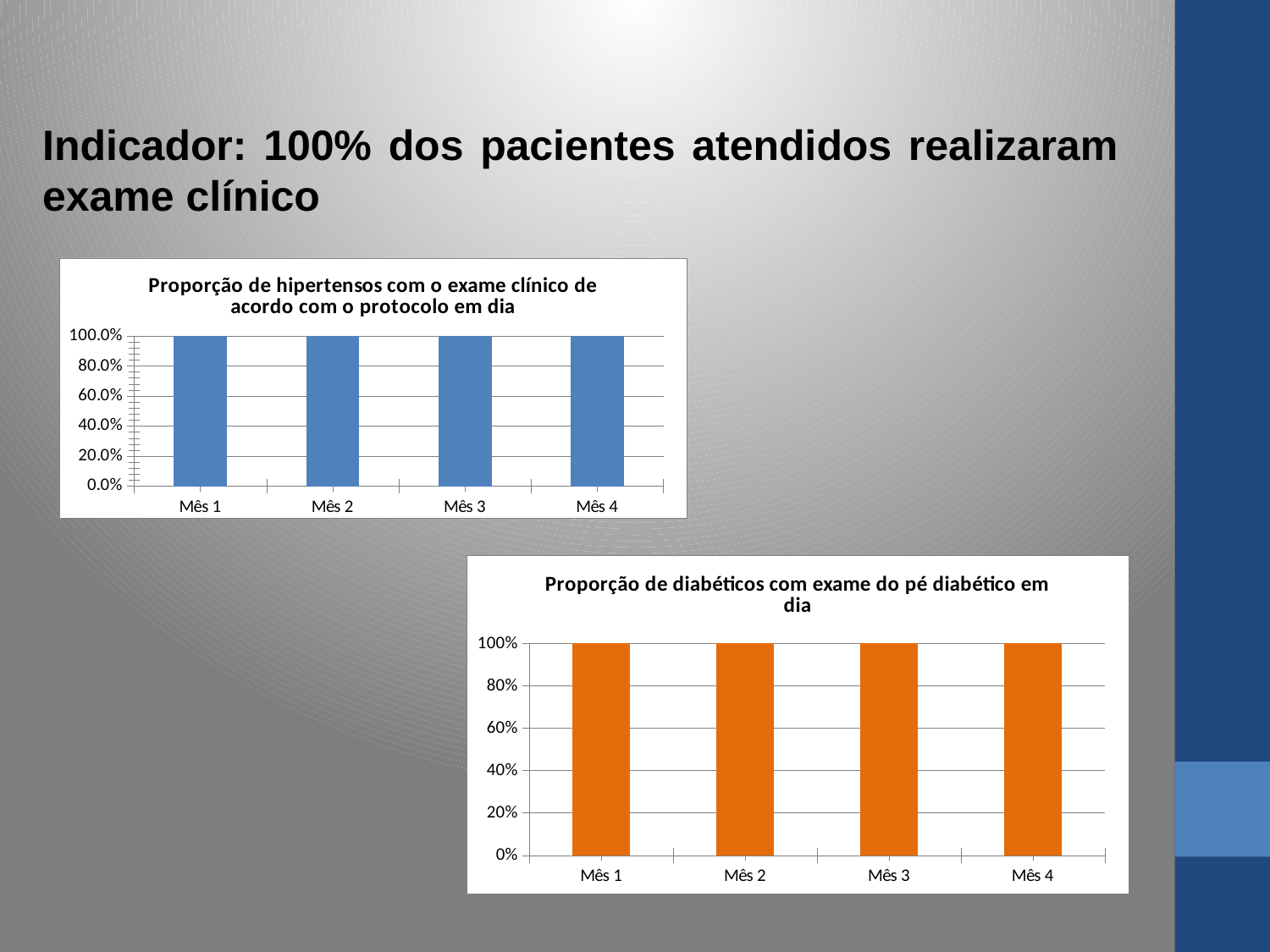
What colour are the bars in the chart titled 'Proporção de diabéticos com exame do pé diabético em dia'? Orange What kind of chart is the bottom-right chart on the slide? Bar chart What is the title of the top-left chart on the slide? Proporção de hipertensos com o exame clínico de acordo com o protocolo em dia In the chart titled 'Proporção de diabéticos com exame do pé diabético em dia', is the value for Mês 2 greater or less than 80%? greater In the chart titled 'Proporção de diabéticos com exame do pé diabético em dia', how many bars are plotted? 4 In the chart titled 'Proporção de hipertensos com o exame clínico de acordo com o protocolo em dia', how many categories are shown on the x axis? 4 What kind of chart is the top-left chart on the slide? Bar chart In the chart titled 'Proporção de hipertensos com o exame clínico de acordo com o protocolo em dia', do the values rise, fall or stay the same from Mês 1 to Mês 4? Stay the same In the chart titled 'Proporção de hipertensos com o exame clínico de acordo com o protocolo em dia', what is the difference between the values for Mês 2 and Mês 4? 0.0% In the chart titled 'Proporção de hipertensos com o exame clínico de acordo com o protocolo em dia', what is the value for Mês 1? 100.0% In the chart titled 'Proporção de diabéticos com exame do pé diabético em dia', what is the value for Mês 3? 100% In the chart titled 'Proporção de diabéticos com exame do pé diabético em dia', do the values rise, fall or stay the same across the months? Stay the same